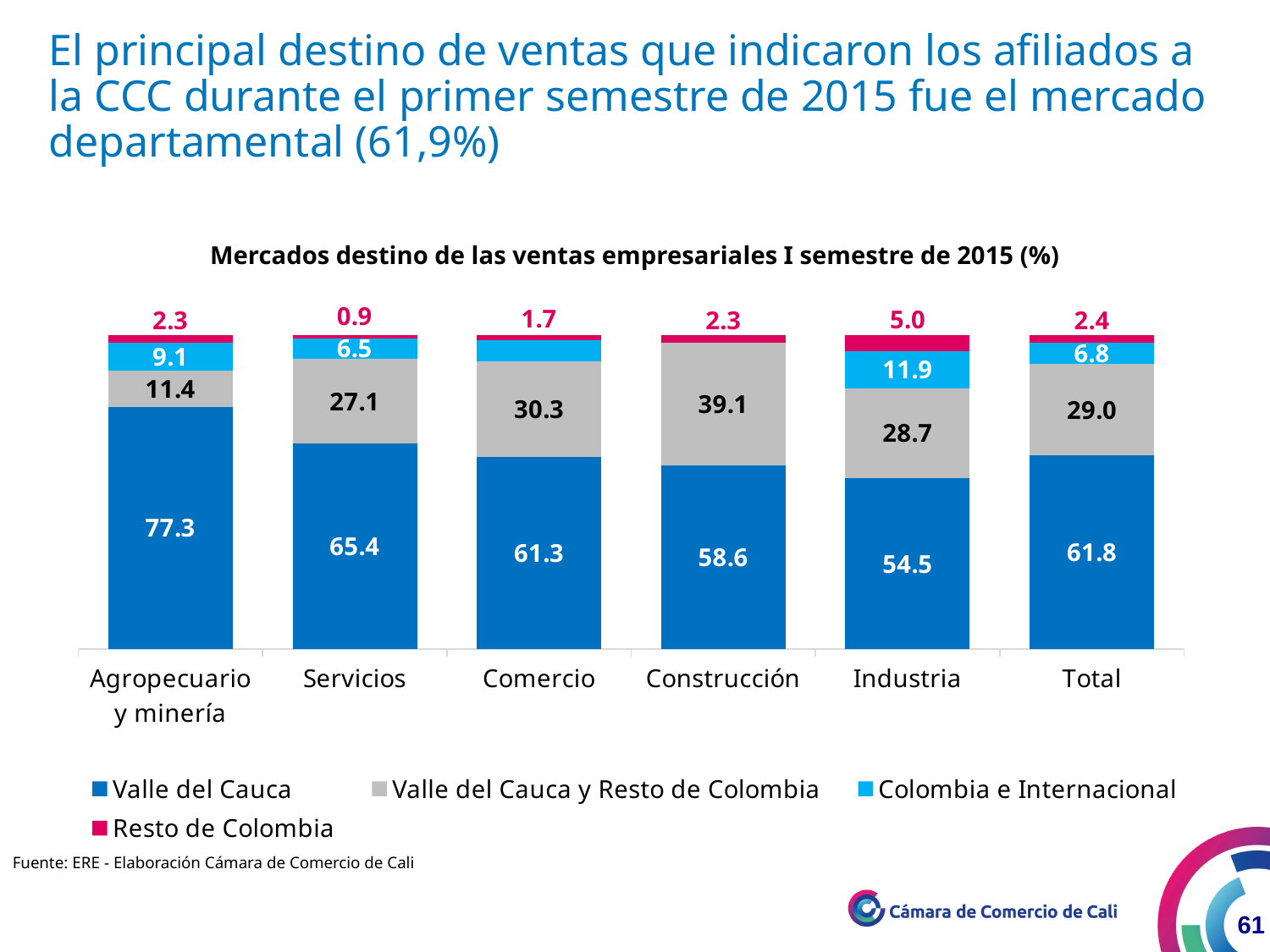
Which category has the lowest value for Resto de Colombia? Servicios What is the value for Colombia e Internacional in the Total bar? 6.8 What is the value for Resto de Colombia in the Industria bar? 5.0 What is the value for Valle del Cauca in the Agropecuario y minería bar? 77.3 Which category has the lowest value for Valle del Cauca? Industria How many categories are shown on the x axis? 6 Which has a larger Valle del Cauca y Resto de Colombia value, Comercio or Servicios? Comercio Which category has the highest value for Valle del Cauca? Agropecuario y minería What is the value for Valle del Cauca y Resto de Colombia in the Construcción bar? 39.1 What is the difference between the Valle del Cauca values for Agropecuario y minería and Industria? 22.8 How many series does the legend list? 4 What kind of chart is shown on the slide? Stacked bar chart